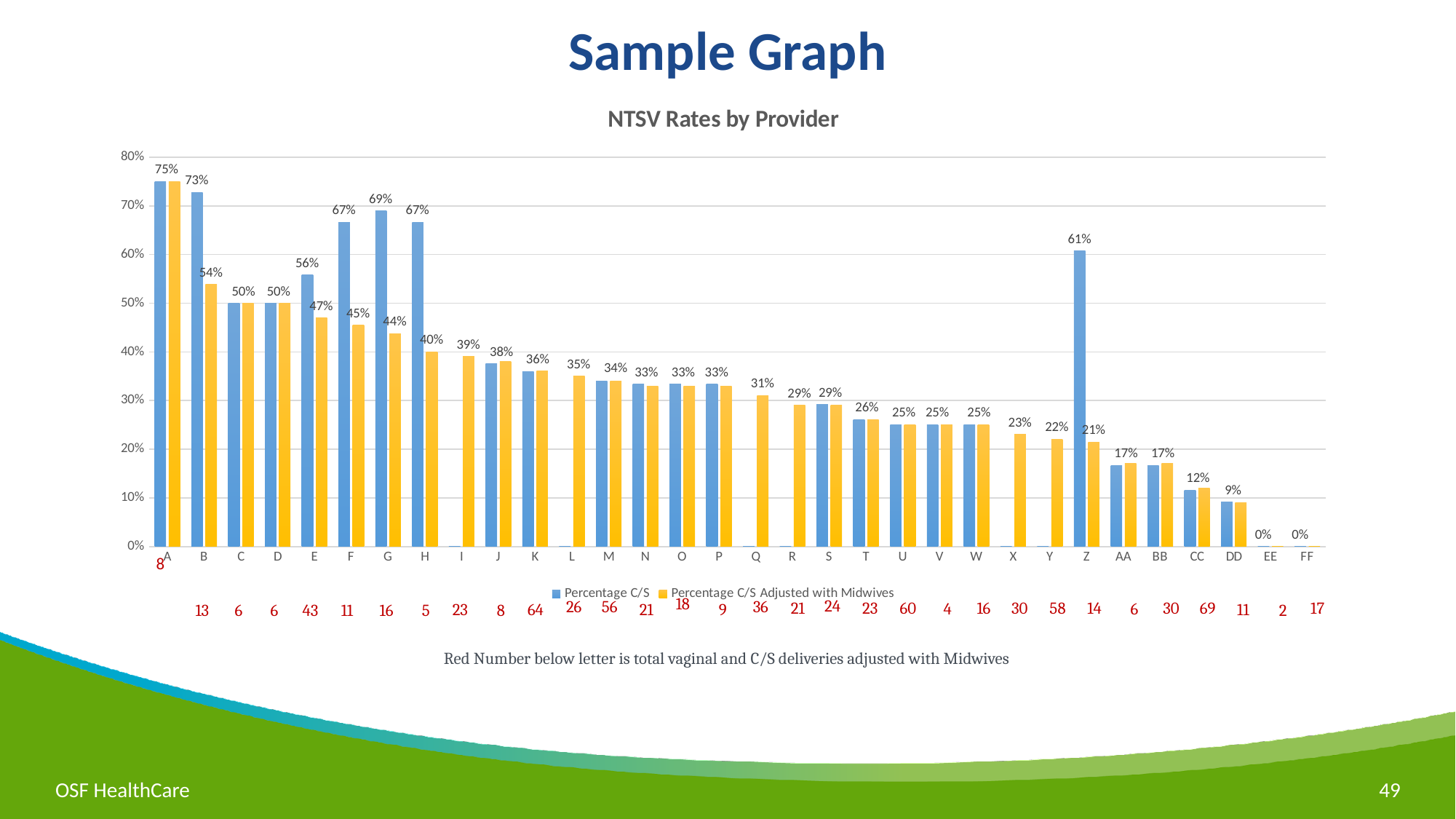
What is the Percentage C/S Adjusted with Midwives value for provider Z? 21% What type of chart is shown on the slide? Bar chart How many providers (categories) are shown on the x axis? 32 What is the Percentage C/S value for provider B? 73% What is the title of the chart? NTSV Rates by Provider For provider G, which is larger: Percentage C/S or Percentage C/S Adjusted with Midwives? Percentage C/S Which provider has the highest Percentage C/S value? A What is the Percentage C/S Adjusted with Midwives value for provider H? 40% How many series does the legend list? 2 Is the Percentage C/S value for provider I greater or less than 10%? less What is the difference between the Percentage C/S and the Percentage C/S Adjusted with Midwives values for provider Z? 40 percentage points Do the Percentage C/S Adjusted with Midwives values generally rise or fall from provider A to provider FF? fall